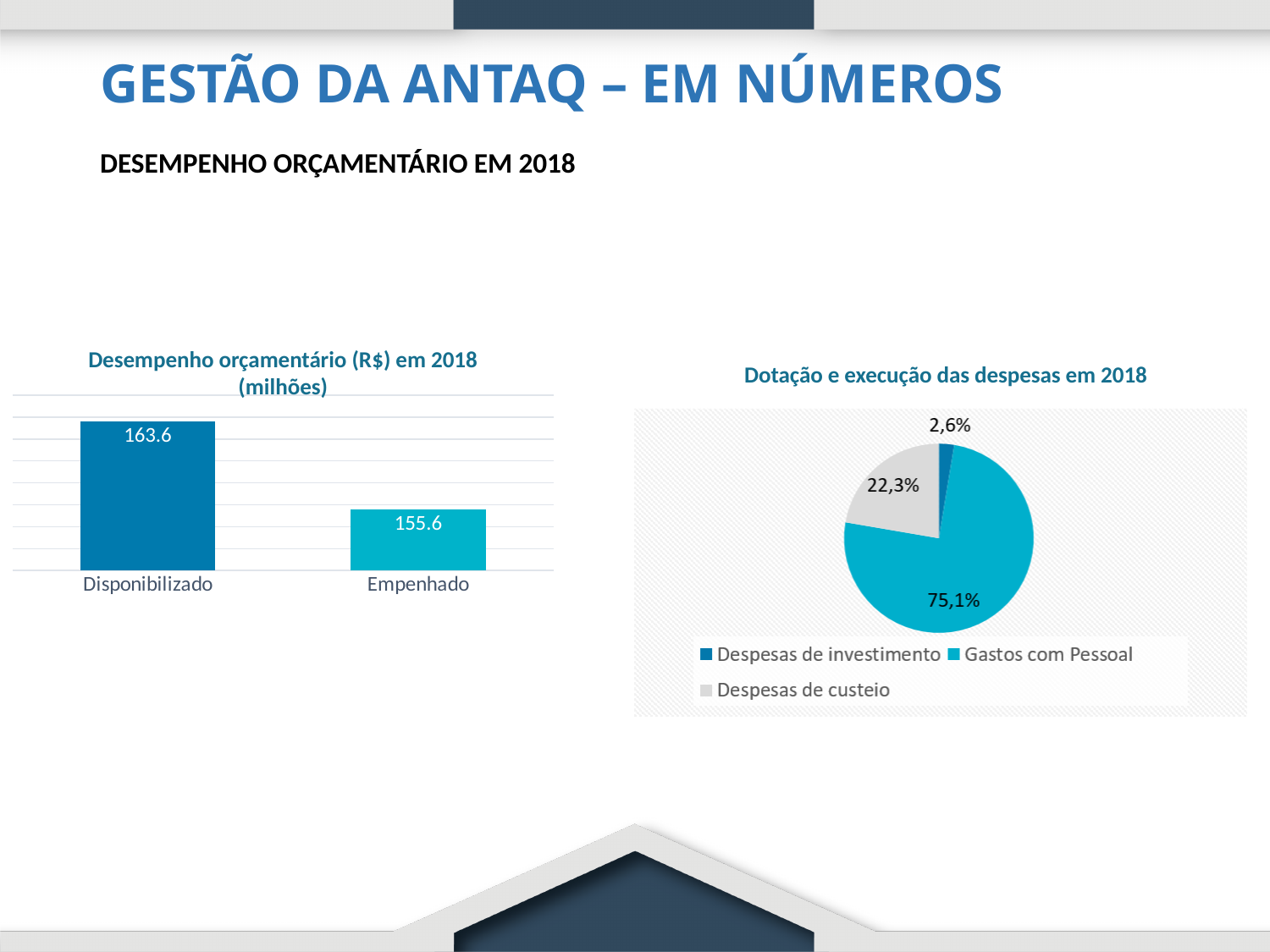
In the chart 'Dotação e execução das despesas em 2018', what share is Gastos com Pessoal? 75,1% In the chart 'Desempenho orçamentário (R$) em 2018 (milhões)', what is the value for Disponibilizado? 163.6 In the chart 'Desempenho orçamentário (R$) em 2018 (milhões)', what is the difference between Disponibilizado and Empenhado? 8.0 In the chart 'Desempenho orçamentário (R$) em 2018 (milhões)', how many categories are shown? 2 What kind of chart is 'Dotação e execução das despesas em 2018'? Pie chart In the chart 'Desempenho orçamentário (R$) em 2018 (milhões)', what is the value for Empenhado? 155.6 What kind of chart is 'Desempenho orçamentário (R$) em 2018 (milhões)'? Bar chart In the chart 'Dotação e execução das despesas em 2018', which category has the smallest slice? Despesas de investimento In the chart 'Dotação e execução das despesas em 2018', what share is Despesas de custeio? 22,3% In the chart 'Desempenho orçamentário (R$) em 2018 (milhões)', which category has the higher value? Disponibilizado In the chart 'Dotação e execução das despesas em 2018', how many entries does the legend list? 3 In the chart 'Dotação e execução das despesas em 2018', what share is Despesas de investimento? 2,6%